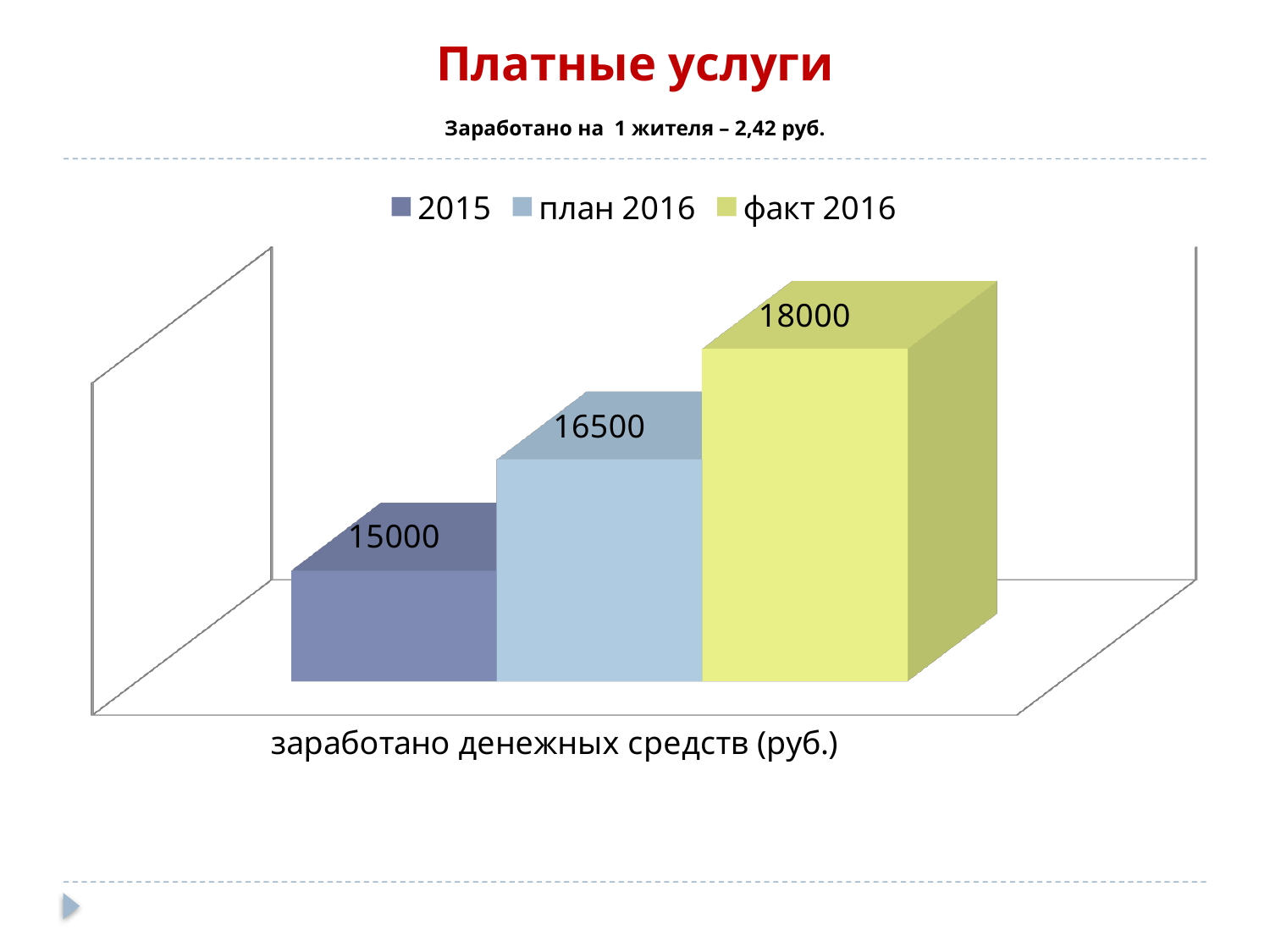
How many series does the legend list? 3 Which series has the highest value? факт 2016 What is the value for факт 2016? 18000 What is the difference between факт 2016 and план 2016? 1500 What is the difference between факт 2016 and 2015? 3000 Which series has the lowest value? 2015 What is the value for план 2016? 16500 Do the values rise or fall from 2015 to факт 2016? rise What is the value for 2015? 15000 What is the label on the x axis of the chart? заработано денежных средств (руб.) What kind of chart is shown? bar chart Which is larger, план 2016 or 2015? план 2016